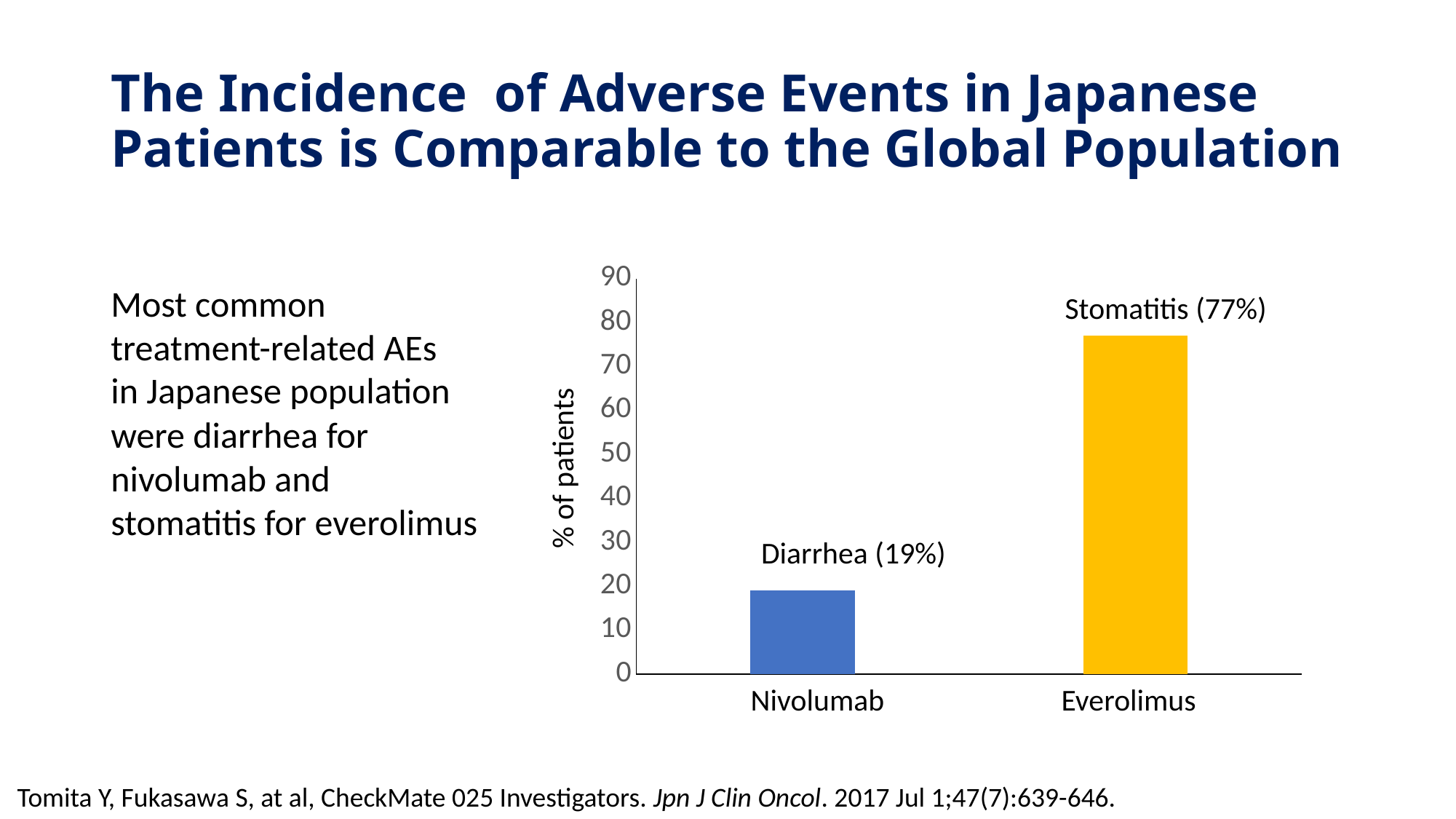
What kind of chart is shown on the slide? Bar chart Which category has the lowest value? Nivolumab How many categories are shown on the x axis? 2 What is the value for Nivolumab? 19% Which adverse event is labelled on the Nivolumab bar? Diarrhea What is the label of the y axis? % of patients Is the value for Nivolumab greater or less than 20? less Which is larger, the value for Nivolumab or the value for Everolimus? Everolimus Which category has the highest value? Everolimus What is the difference between the values for Everolimus and Nivolumab? 58% What is the value for Everolimus? 77% Is the value for Everolimus greater or less than 70? greater